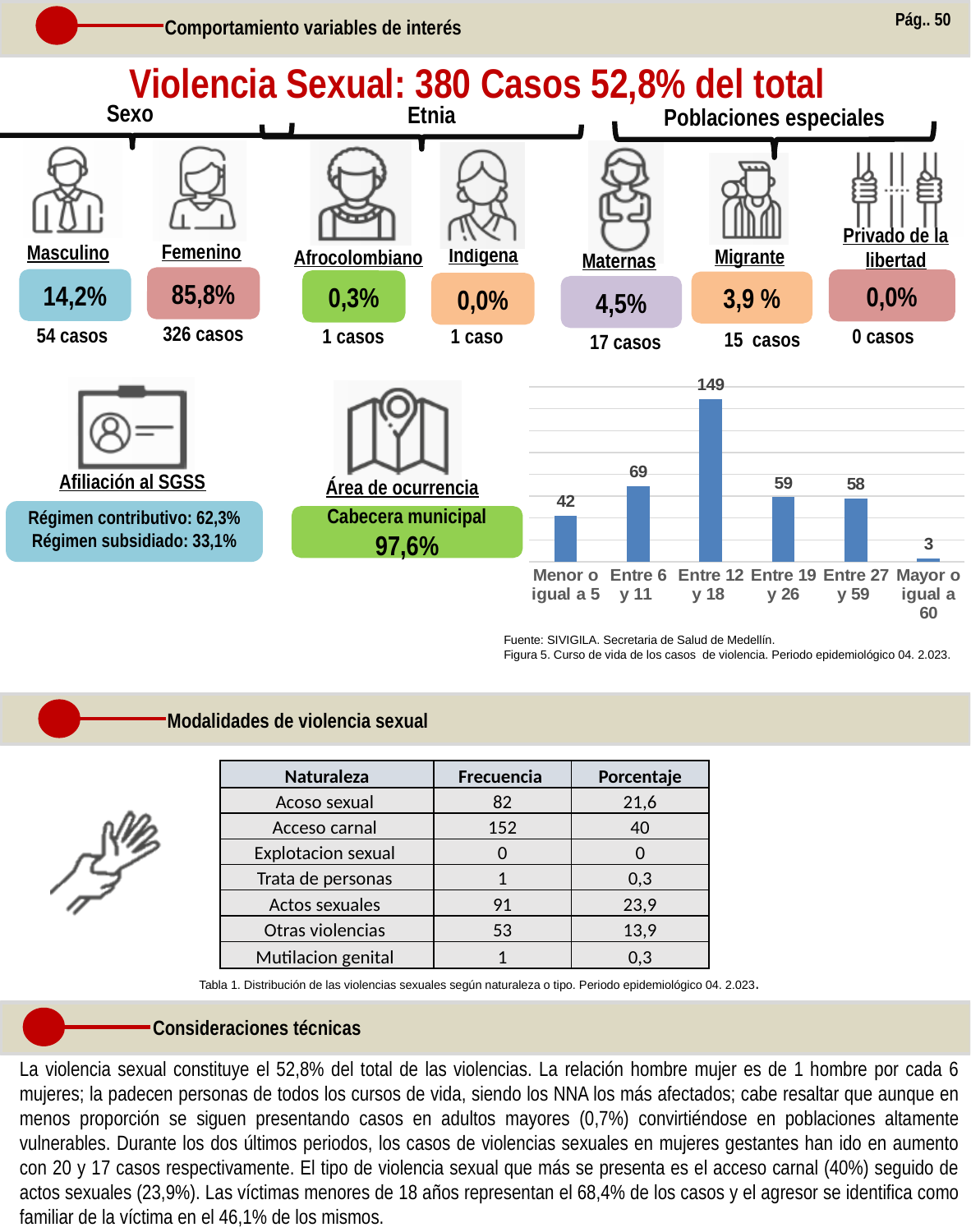
In the bar chart (Figura 5), what is the difference between the values for 'Entre 12 y 18' and 'Entre 6 y 11'? 80 According to the caption, what is the source of the data in Figura 5? SIVIGILA. Secretaria de Salud de Medellín. In the bar chart (Figura 5), which is larger: the value for 'Entre 6 y 11' or the value for 'Menor o igual a 5'? Entre 6 y 11 In the bar chart (Figura 5), what is the value for 'Entre 6 y 11'? 69 How many age-group categories are shown in the bar chart (Figura 5)? 6 In the bar chart (Figura 5), which age group has the highest number of cases? Entre 12 y 18 In the bar chart (Figura 5), what is the difference between the values for 'Entre 19 y 26' and 'Entre 27 y 59'? 1 In the bar chart (Figura 5), which age group has the lowest number of cases? Mayor o igual a 60 In the bar chart (Figura 5), what is the value for the 'Entre 12 y 18' age group? 149 In the bar chart (Figura 5), what is the value for 'Menor o igual a 5'? 42 What type of chart is Figura 5 on the slide? Bar chart In the bar chart (Figura 5), what is the value for 'Mayor o igual a 60'? 3